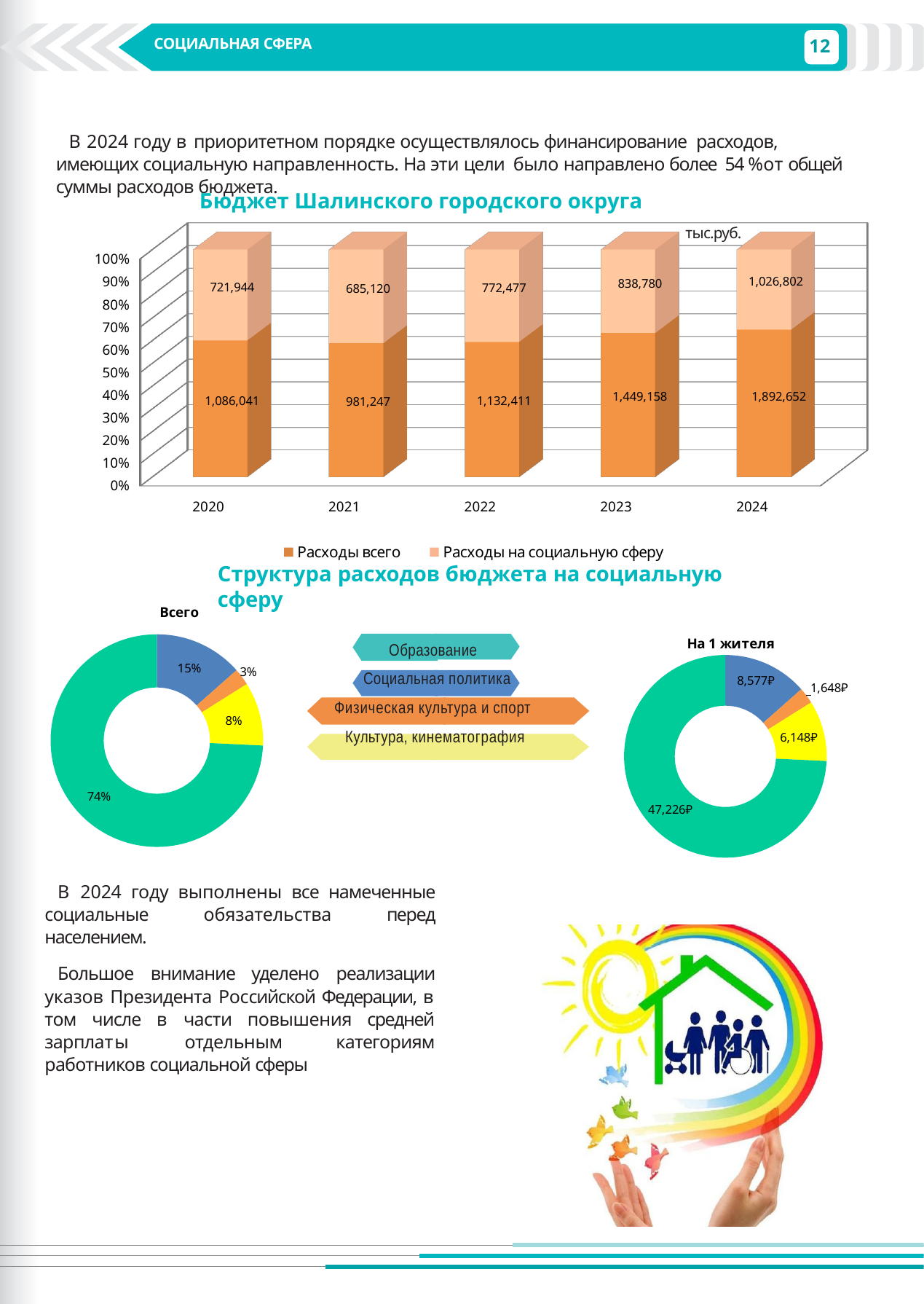
In the donut chart 'На 1 жителя', what is the value for 'Социальная политика'? 8,577₽ In the chart 'Бюджет Шалинского городского округа', how many years are shown on the x axis? 5 In the donut chart 'Всего', what share does 'Образование' have? 74% What kind of chart is 'Бюджет Шалинского городского округа'? Stacked bar chart In the chart 'Бюджет Шалинского городского округа', which year has the highest value of 'Расходы на социальную сферу'? 2024 In the chart 'Бюджет Шалинского городского округа', how many series does the legend list? 2 In the chart 'Бюджет Шалинского городского округа', what is the difference between 'Расходы всего' in 2024 and in 2023? 443,494 In the chart 'Бюджет Шалинского городского округа', which year has the lowest value of 'Расходы всего'? 2021 In the chart 'Бюджет Шалинского городского округа', what is the value of 'Расходы на социальную сферу' for 2021? 685,120 In the chart 'Бюджет Шалинского городского округа', what is the value of 'Расходы всего' for 2024? 1,892,652 In the chart 'Бюджет Шалинского городского округа', does 'Расходы на социальную сферу' rise or fall from 2021 to 2024? Rise In the donut chart 'На 1 жителя', which category has the smallest value? Физическая культура и спорт